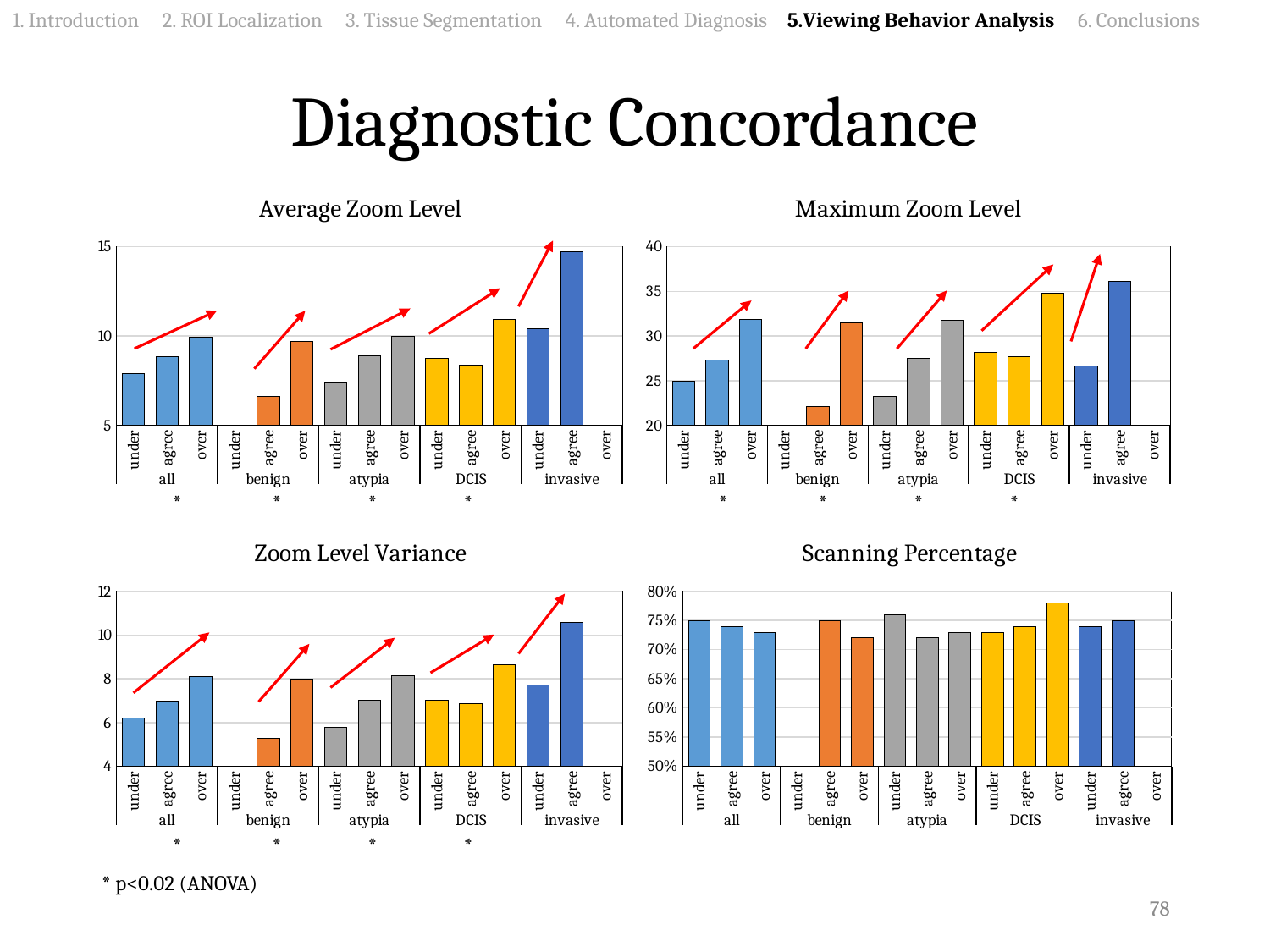
In the Maximum Zoom Level chart, which bar is the lowest? benign agree In the Average Zoom Level chart, which bar is the highest? invasive agree In the Scanning Percentage chart, which bar is the highest? DCIS over In the Average Zoom Level chart, is the value for DCIS over greater or less than 10? greater How many diagnostic groups (all, benign, etc.) are shown along the x axis of the Scanning Percentage chart? 5 What kind of chart is the Average Zoom Level chart? bar chart In the Zoom Level Variance chart, which bar is the highest? invasive agree In the Average Zoom Level chart, which bar is the lowest? benign agree In the Average Zoom Level chart, do the values for the 'all' group rise or fall from under to over? rise In the Maximum Zoom Level chart, is the value for DCIS over greater or less than 30? greater How many charts are shown on the slide? 4